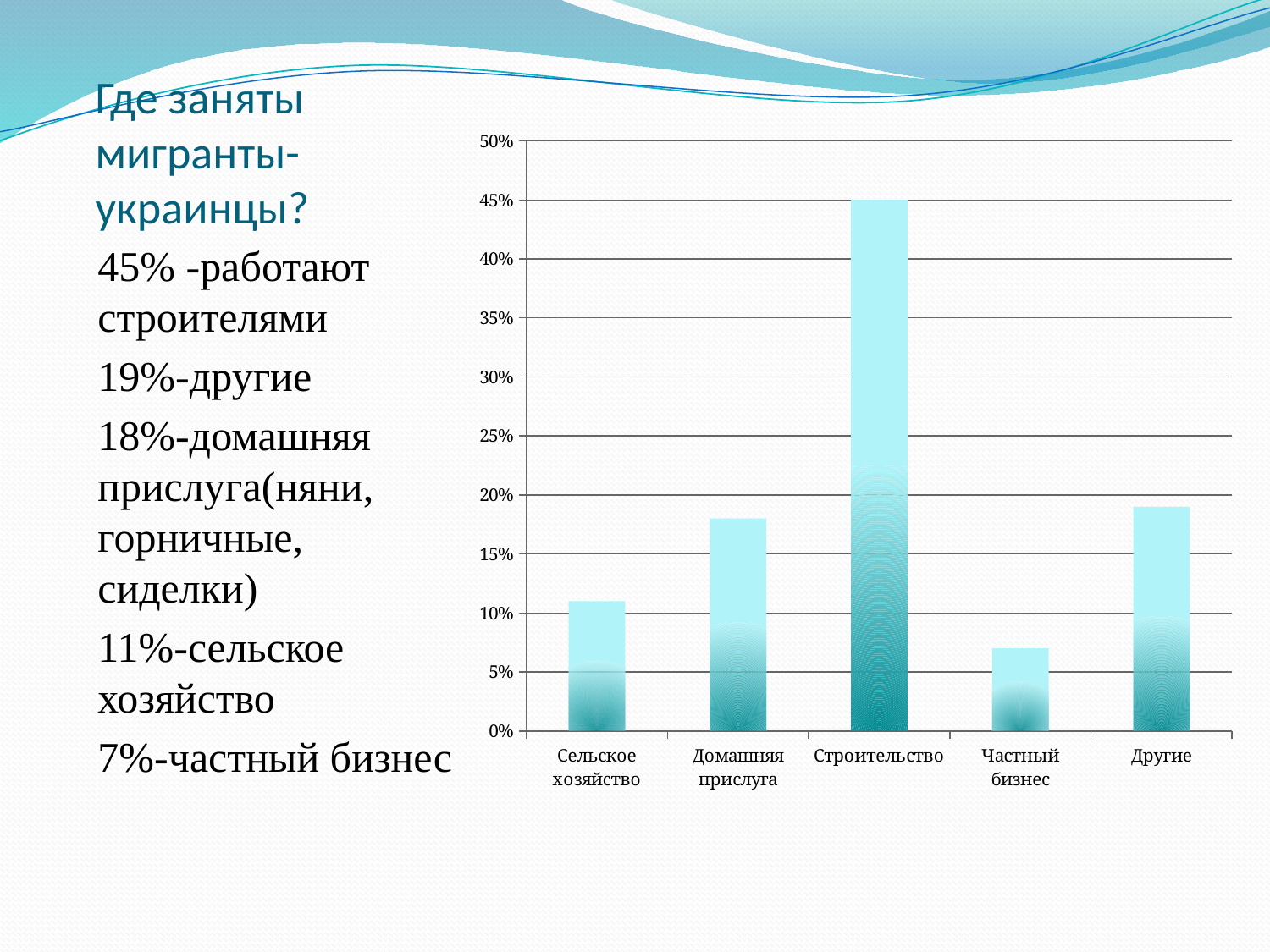
Which is larger, the value for Домашняя прислуга or the value for Частный бизнес? Домашняя прислуга What is the difference between the value for Строительство and the value for Другие? 26% What is the value for Другие? 19% Which category has the lowest value in the chart? Частный бизнес Is the value for Сельское хозяйство greater or less than 10%? greater What type of chart is shown on the slide? bar chart What is the value for Строительство? 45% Which category has the highest value in the chart? Строительство What is the value for Частный бизнес? 7% What is the value for Домашняя прислуга? 18% What is the value for Сельское хозяйство? 11% How many categories are shown on the x axis of the chart? 5